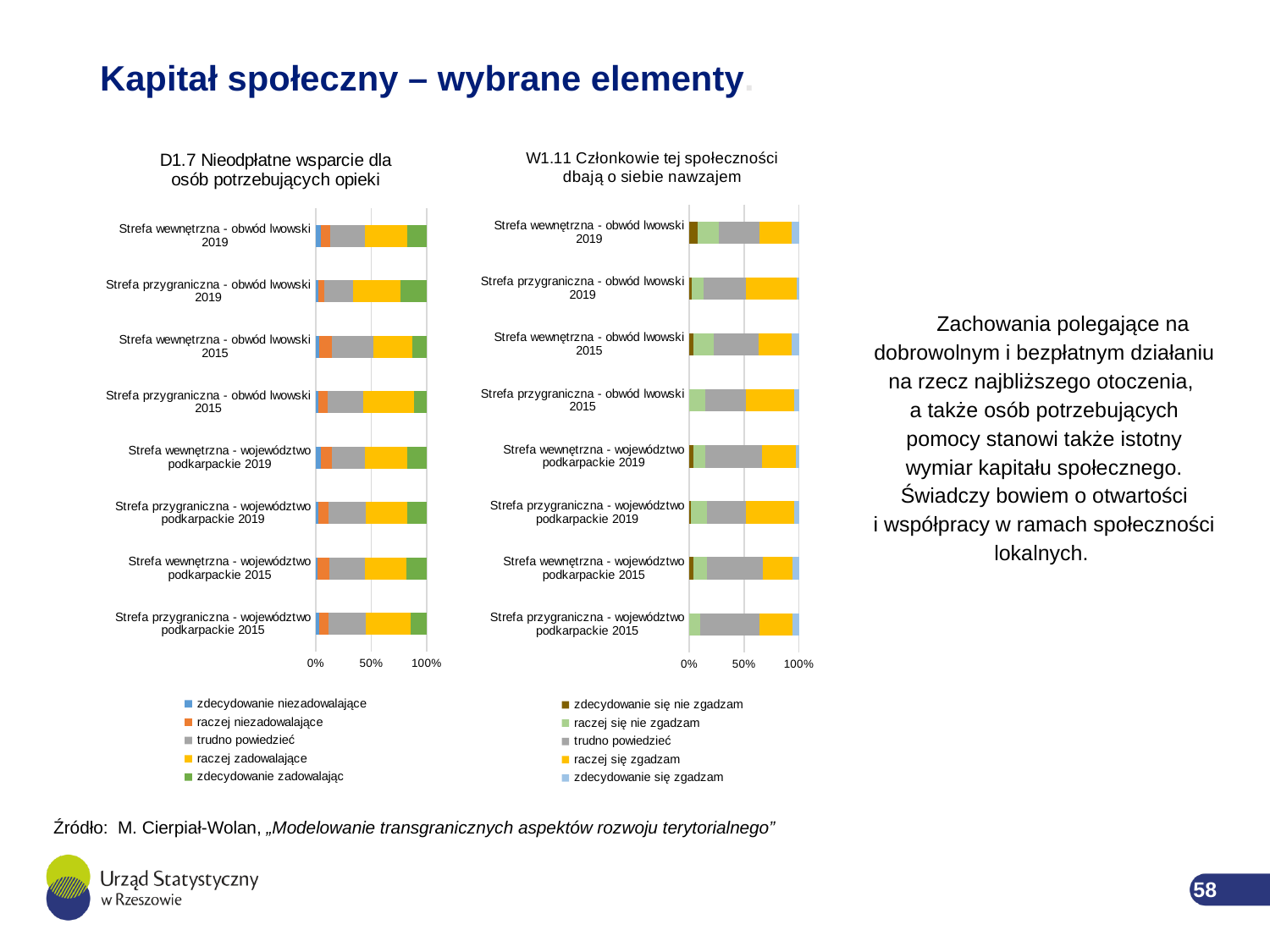
In the left chart "D1.7 Nieodpłatne wsparcie dla osób potrzebujących opieki", which legend entry is shown in yellow? raczej zadowalające What kind of chart is the right chart titled "W1.11 Członkowie tej społeczności dbają o siebie nawzajem"? Stacked bar chart In the right chart "W1.11 Członkowie tej społeczności dbają o siebie nawzajem", which legend entry is shown in light blue? zdecydowanie się zgadzam How many series does the legend of the right chart "W1.11 Członkowie tej społeczności dbają o siebie nawzajem" list? 5 How many categories (bars) are shown in the right chart "W1.11 Członkowie tej społeczności dbają o siebie nawzajem"? 8 What is the highest tick value shown on the x axis of the left chart "D1.7 Nieodpłatne wsparcie dla osób potrzebujących opieki"? 100% What is the label of the bottom category in the right chart "W1.11 Członkowie tej społeczności dbają o siebie nawzajem"? Strefa przygraniczna - województwo podkarpackie 2015 How many categories (bars) are shown in the left chart "D1.7 Nieodpłatne wsparcie dla osób potrzebujących opieki"? 8 What kind of chart is the left chart titled "D1.7 Nieodpłatne wsparcie dla osób potrzebujących opieki"? Stacked bar chart How many series does the legend of the left chart "D1.7 Nieodpłatne wsparcie dla osób potrzebujących opieki" list? 5